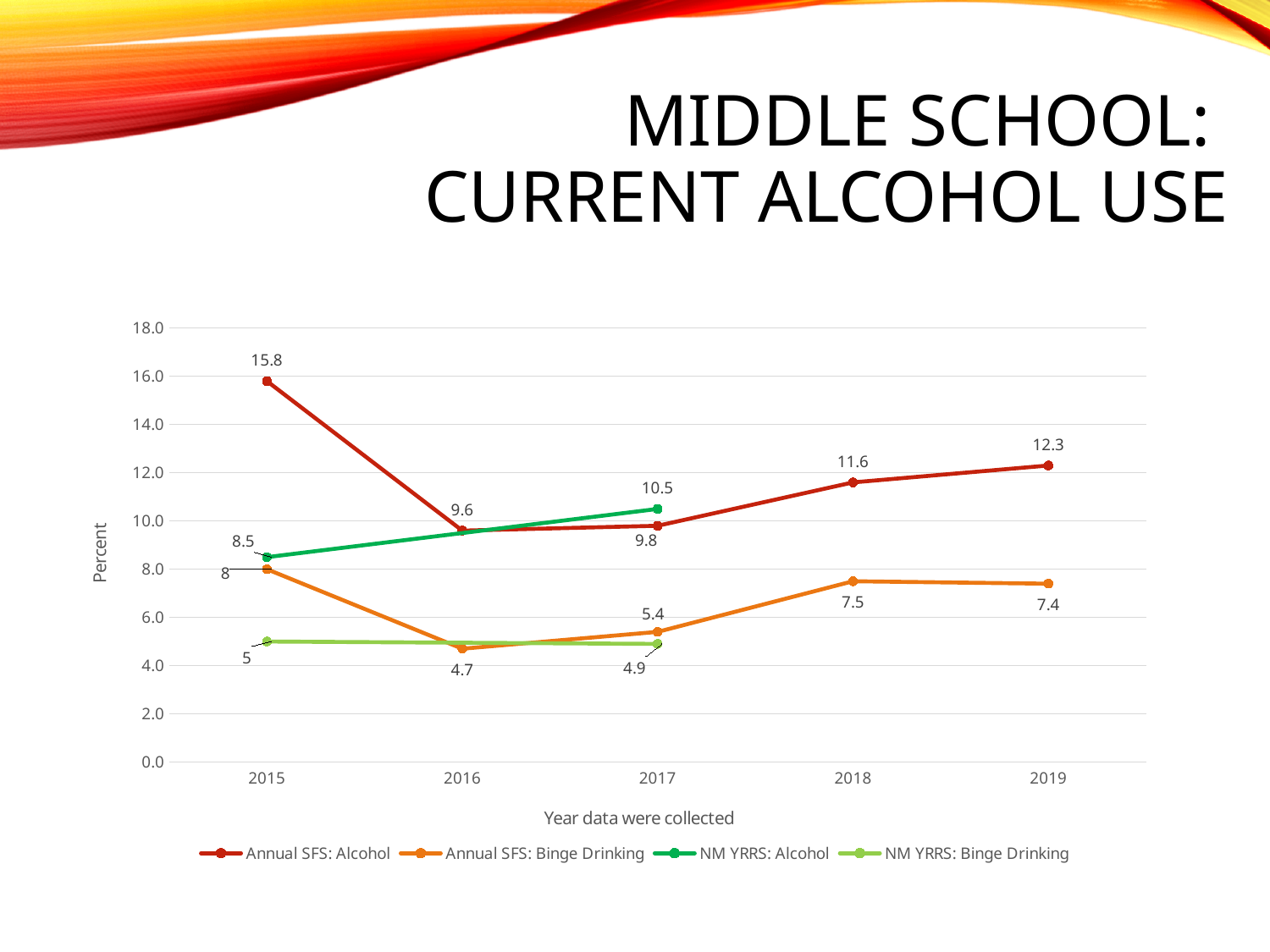
What is the value for NM YRRS: Binge Drinking in 2015? 5 What kind of chart is shown on the slide? line chart In which year is the Annual SFS: Binge Drinking value lowest? 2016 In 2018, which is larger: Annual SFS: Alcohol or Annual SFS: Binge Drinking? Annual SFS: Alcohol In which year is the Annual SFS: Alcohol value highest? 2015 What is the value for Annual SFS: Binge Drinking in 2016? 4.7 What is the value for Annual SFS: Alcohol in 2019? 12.3 How many series does the legend list? 4 What is the value for NM YRRS: Alcohol in 2017? 10.5 What is the difference between the Annual SFS: Alcohol values in 2015 and 2019? 3.5 What is the value for Annual SFS: Alcohol in 2015? 15.8